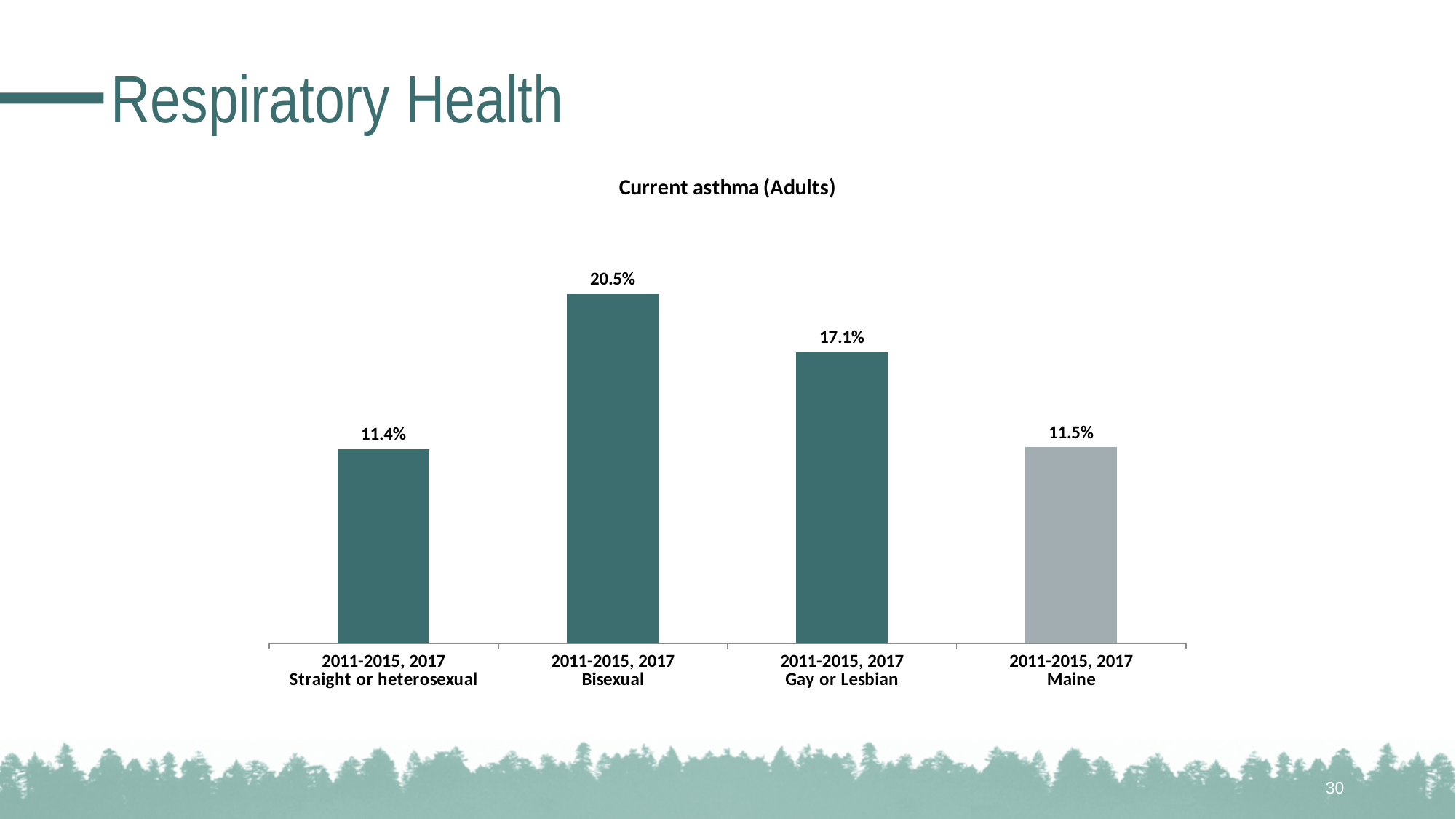
What is the current asthma rate for Maine overall? 11.5% Which group has the lowest current asthma rate? Straight or heterosexual What type of chart is shown on the slide? Bar chart What is the title of the chart? Current asthma (Adults) How many bars are shown in the chart? 4 Which group has the highest current asthma rate? Bisexual What is the current asthma rate for Straight or heterosexual adults? 11.4% What is the current asthma rate for Gay or Lesbian adults? 17.1% What is the difference between the current asthma rates for Bisexual and Straight or heterosexual adults? 9.1% Which is larger, the current asthma rate for Gay or Lesbian adults or for Maine overall? Gay or Lesbian What is the current asthma rate for Bisexual adults? 20.5% What is the difference between the current asthma rates for Bisexual and Gay or Lesbian adults? 3.4%